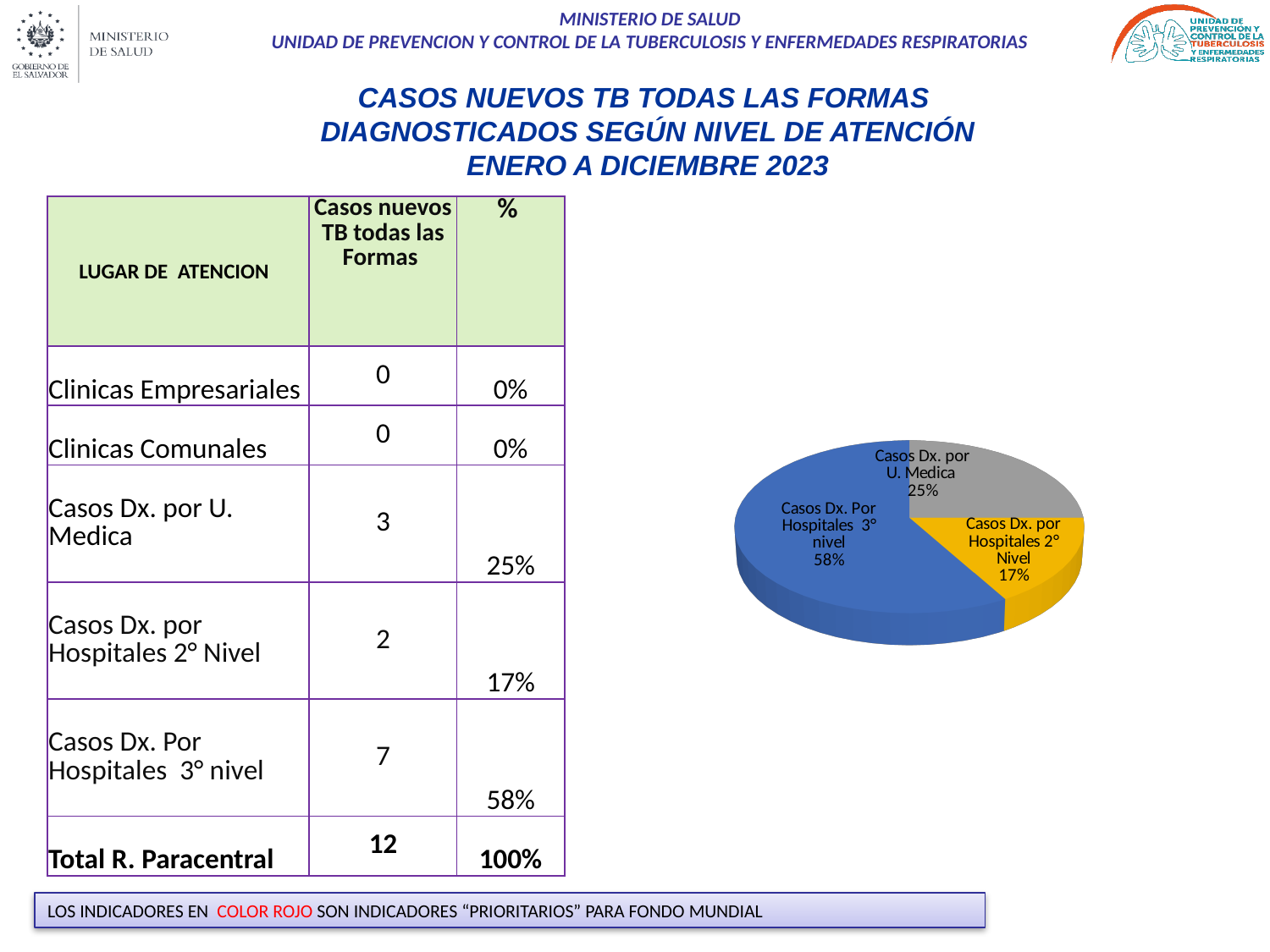
Which is larger in the pie chart: the slice for Casos Dx. por U. Medica or the slice for Casos Dx. por Hospitales 2° Nivel? Casos Dx. por U. Medica What colour is the slice for Casos Dx. Por Hospitales 3° nivel in the pie chart? Blue What share of the pie does the slice for Casos Dx. Por Hospitales 3° nivel represent? 58% What colour is the slice for Casos Dx. por Hospitales 2° Nivel in the pie chart? Yellow What kind of chart is shown on the slide? Pie chart How many slices does the pie chart have? 3 What share of the pie does the slice for Casos Dx. por Hospitales 2° Nivel represent? 17% What is the difference in percentage points between the slice for Casos Dx. Por Hospitales 3° nivel and the slice for Casos Dx. por U. Medica? 33 percentage points Which slice of the pie chart is the largest? Casos Dx. Por Hospitales 3° nivel What share of the pie does the slice for Casos Dx. por U. Medica represent? 25% Which slice of the pie chart is the smallest? Casos Dx. por Hospitales 2° Nivel What is the difference in percentage points between the slice for Casos Dx. por U. Medica and the slice for Casos Dx. por Hospitales 2° Nivel? 8 percentage points